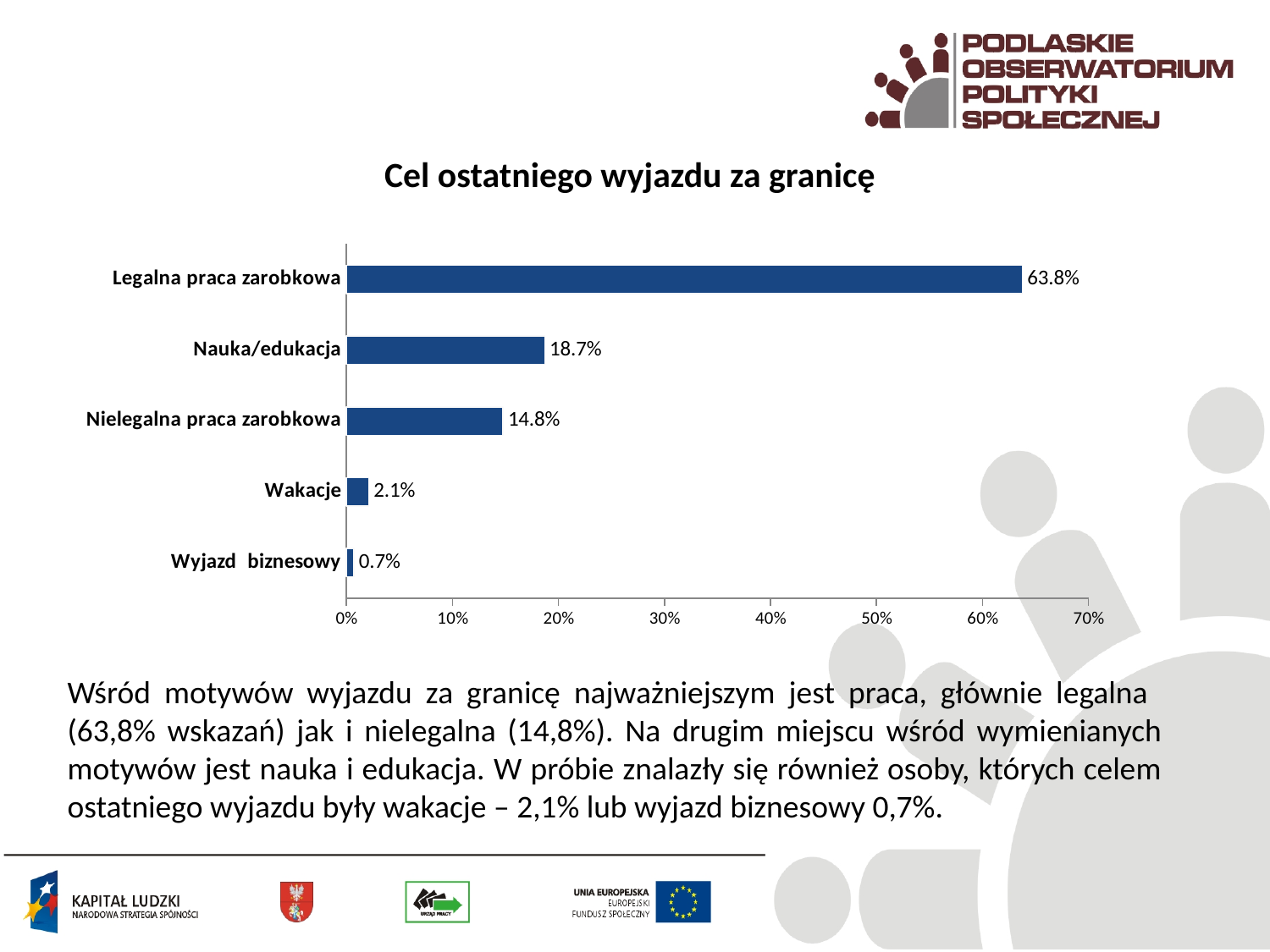
What is the difference between the values for Legalna praca zarobkowa and Nauka/edukacja? 45.1% What kind of chart is shown on the slide? bar chart Which is larger, the value for Nauka/edukacja or the value for Nielegalna praca zarobkowa? Nauka/edukacja What is the value for Nielegalna praca zarobkowa? 14.8% What is the value for Wyjazd biznesowy? 0.7% What is the value for Nauka/edukacja? 18.7% Is the value for Legalna praca zarobkowa greater or less than 60%? greater Which category has the lowest value? Wyjazd biznesowy Which category has the highest value? Legalna praca zarobkowa How many categories are shown in the chart? 5 What is the value for Wakacje? 2.1% What is the value for Legalna praca zarobkowa? 63.8%